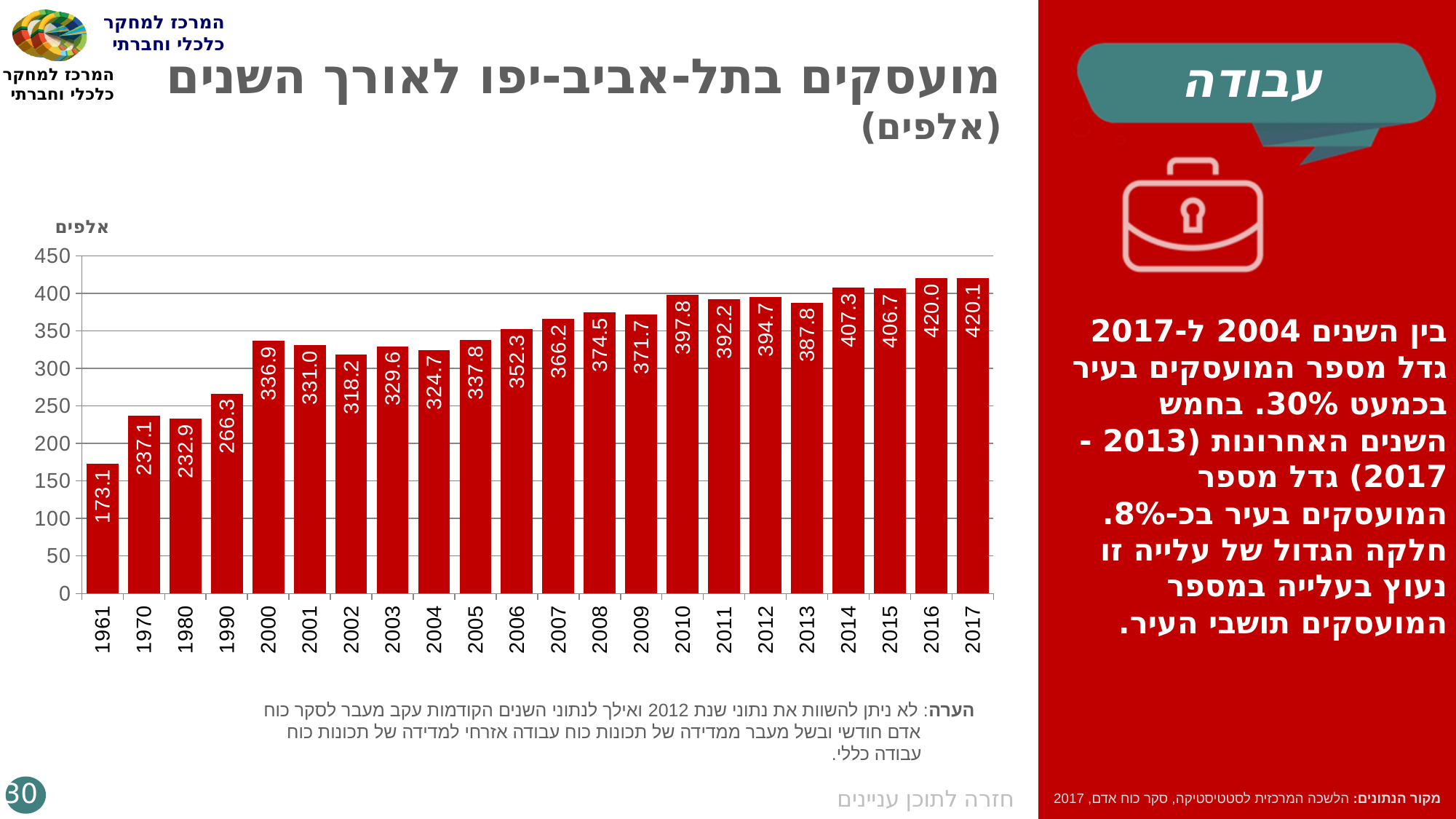
How many years are shown on the x axis? 22 What is the difference between the values for 1970 and 1961? 64.0 Which year has the lowest value? 1961 What is the difference between the values for 2017 and 2004? 95.4 Which is larger, the value for 2002 or the value for 2006? 2006 What type of chart is shown on the slide? bar chart What is the value for 2017? 420.1 What is the value for 1961? 173.1 Do the values generally rise or fall from 1961 to 2017? rise Is the value for 1990 greater or less than 300? less What is the value for 2010? 397.8 What is the value for 2000? 336.9